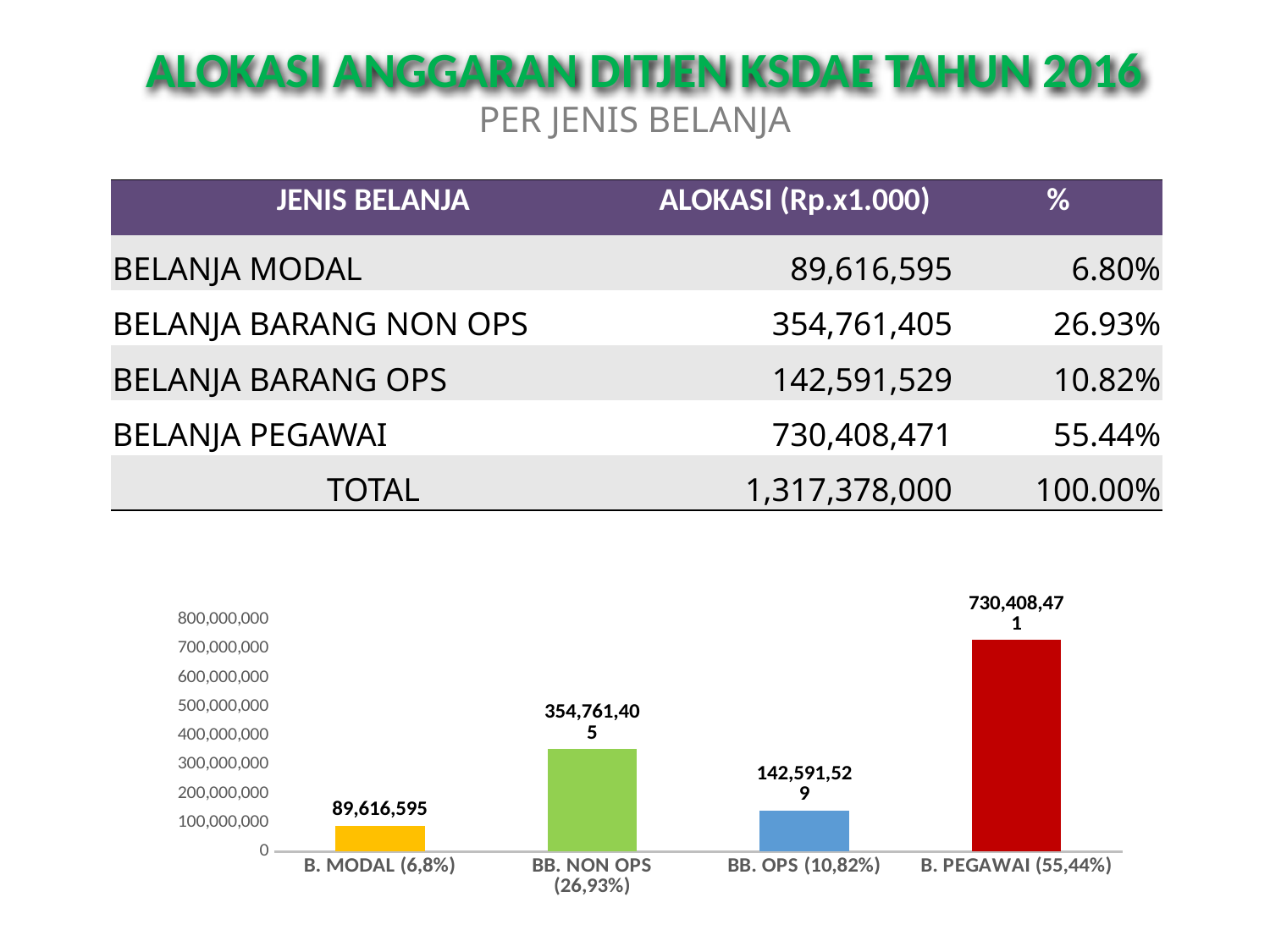
How many categories are shown on the x axis of the chart? 4 Is the value for BB. NON OPS (26,93%) greater or less than 300,000,000? greater What is the difference between the values for B. PEGAWAI (55,44%) and BB. NON OPS (26,93%)? 375,647,066 Which category has the lowest bar? B. MODAL (6,8%) What kind of chart is shown on the slide? bar chart What is the value of the bar for BB. OPS (10,82%)? 142,591,529 What is the value of the bar for B. PEGAWAI (55,44%)? 730,408,471 What is the value of the bar for B. MODAL (6,8%)? 89,616,595 Which is larger, the bar for BB. OPS (10,82%) or the bar for B. MODAL (6,8%)? BB. OPS (10,82%) Which category has the highest bar? B. PEGAWAI (55,44%) What is the value of the bar for BB. NON OPS (26,93%)? 354,761,405 What colour is the bar for B. PEGAWAI (55,44%)? red